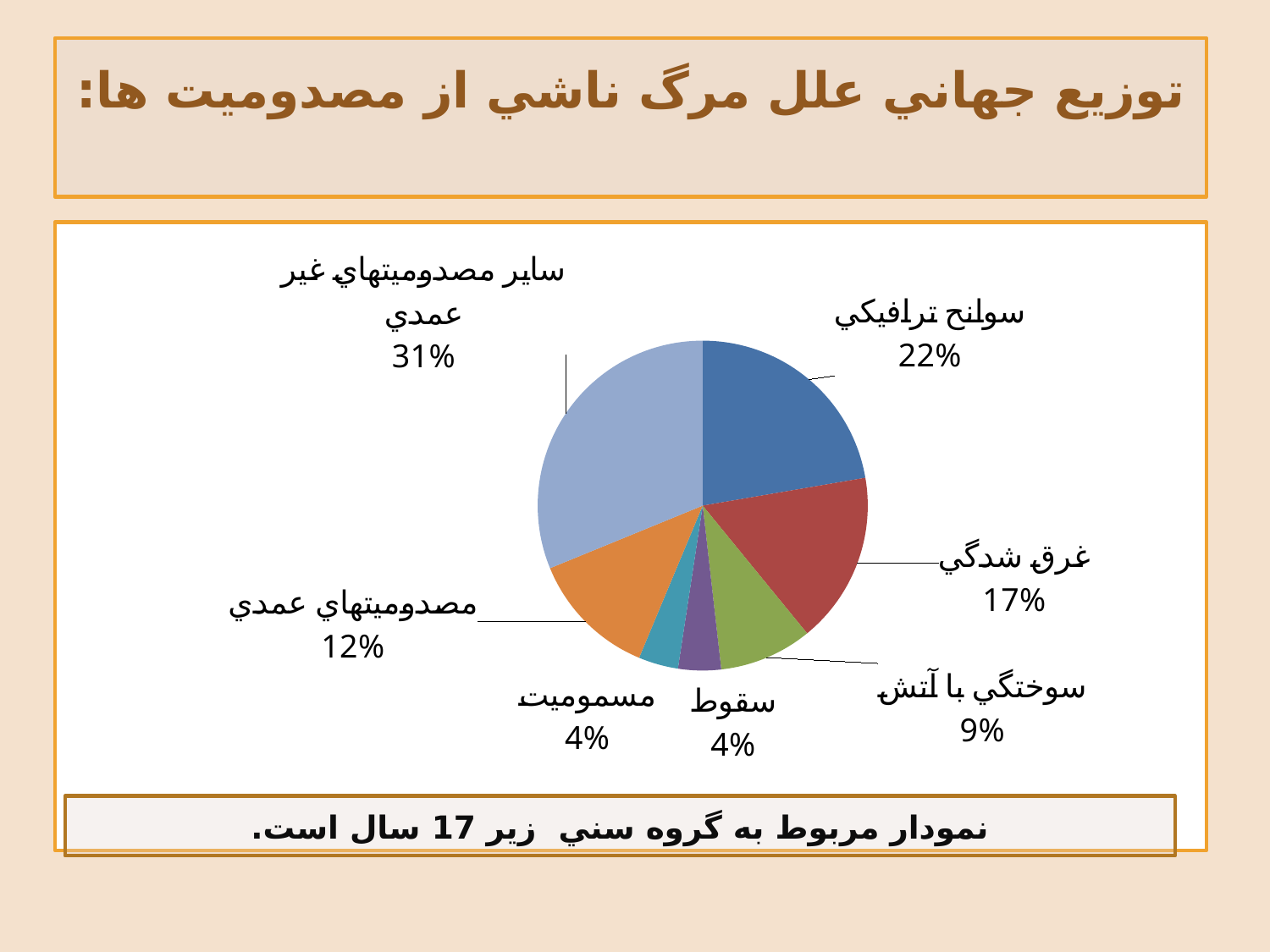
Which is larger, the slice for غرق شدگي or the slice for مصدوميتهاي عمدي? غرق شدگي What share of the pie is labelled غرق شدگي? 17% Which category has the largest slice of the pie? ساير مصدوميتهاي غير عمدي What share of the pie is labelled سوانح ترافيكي? 22% What share of the pie is labelled مصدوميتهاي عمدي? 12% What is the difference in percentage points between سوانح ترافيكي and سوختگي با آتش? 13 According to the caption below the chart, which age group does the chart refer to? زير 17 سال What percentage is shown for سقوط? 4% What kind of chart is shown on the slide? pie chart What is the percentage shown for the largest slice, ساير مصدوميتهاي غير عمدي? 31% How many slices does the pie chart have? 7